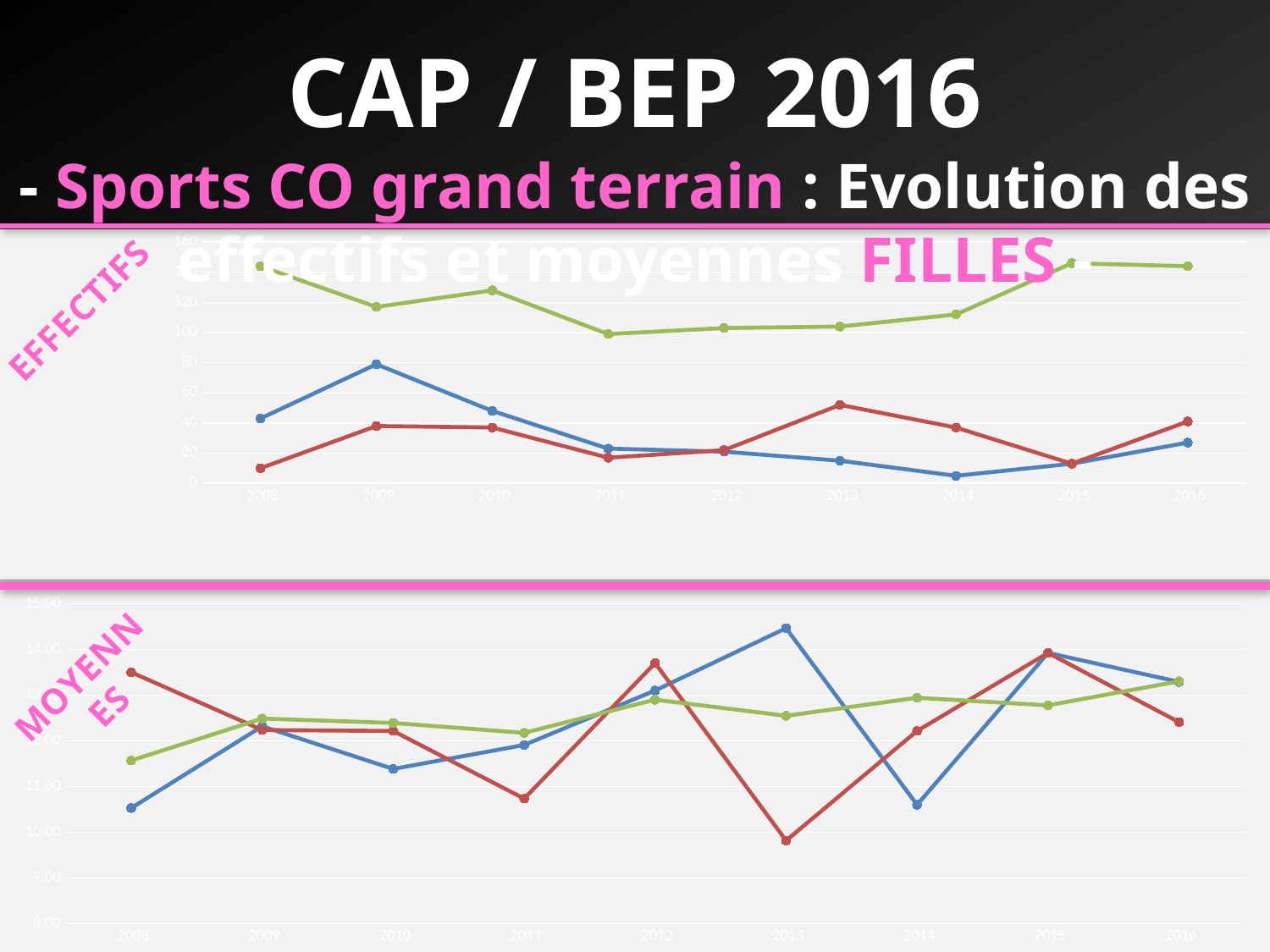
In the top chart (EFFECTIFS), is the value of the blue line in 2009 greater or less than 60? greater In the top chart (EFFECTIFS), in which year does the red line reach its highest value? 2013 What is the first year and the last year shown on the x axis of the bottom chart (MOYENNES)? 2008 and 2016 In the bottom chart (MOYENNES), in which year does the blue line reach its highest value? 2013 In the top chart (EFFECTIFS), which line has the higher value in 2013, the red line or the blue line? red line In the top chart (EFFECTIFS), in which year does the blue line reach its highest value? 2009 In the bottom chart (MOYENNES), is the value of the red line in 2013 greater or less than 10.00? less What kind of chart is the top chart (EFFECTIFS)? line chart How many years are plotted along the x axis of the top chart (EFFECTIFS)? 9 In the bottom chart (MOYENNES), in which year does the red line reach its lowest value? 2013 In the top chart (EFFECTIFS), in which year does the blue line reach its lowest value? 2014